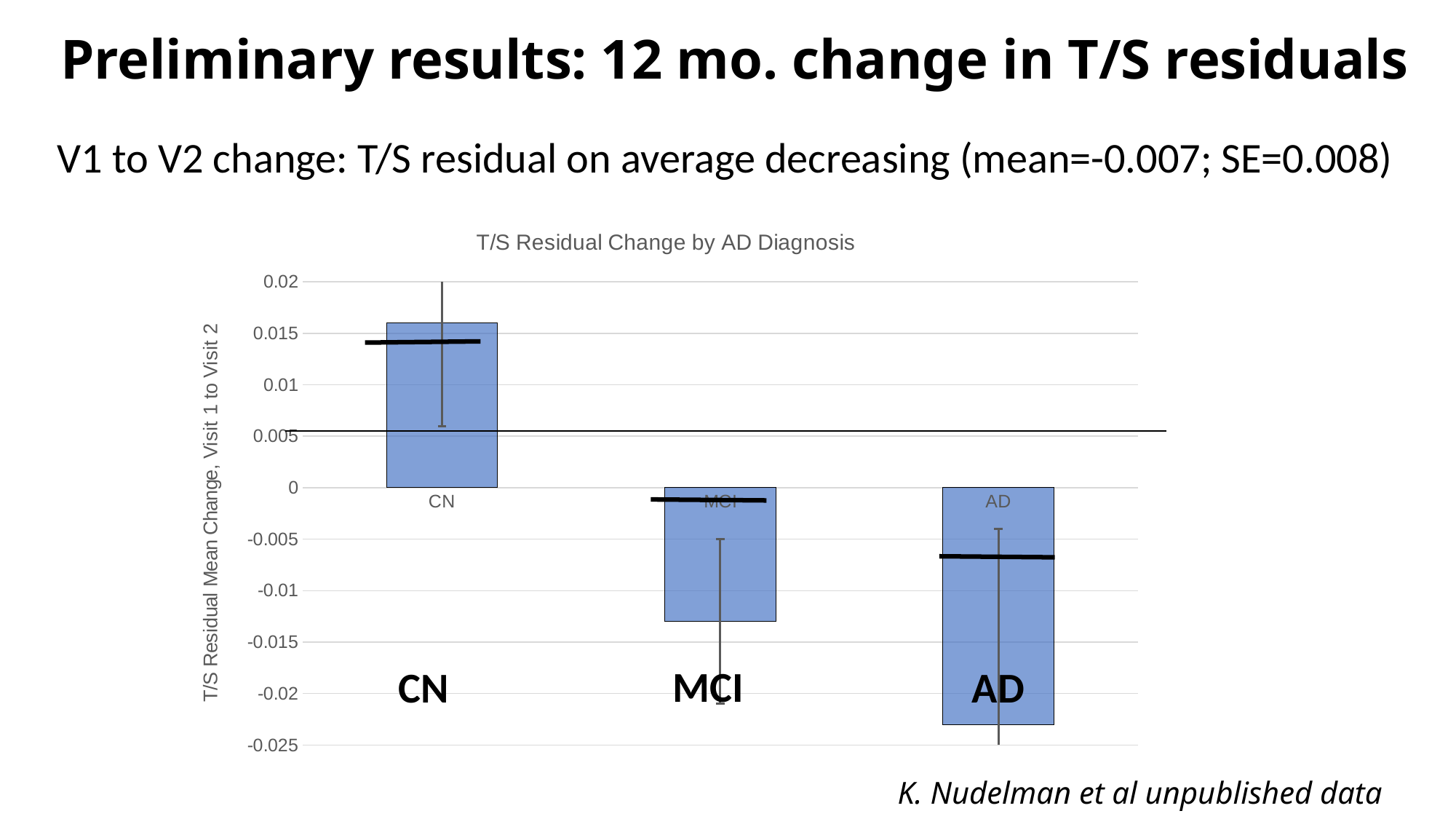
What is the label of the vertical axis of the chart? T/S Residual Mean Change, Visit 1 to Visit 2 How many diagnosis categories are plotted in the chart? 3 Is the value for CN greater or less than 0.01? greater Which has the larger T/S residual mean change, MCI or AD? MCI Is the value for AD greater or less than -0.02? less What is the title of the chart? T/S Residual Change by AD Diagnosis Is the value for CN greater or less than 0.02? less Which diagnosis group has the lowest T/S residual mean change? AD Which has the larger T/S residual mean change, CN or MCI? CN What type of chart is shown on the slide? bar chart Which diagnosis group has the highest T/S residual mean change? CN